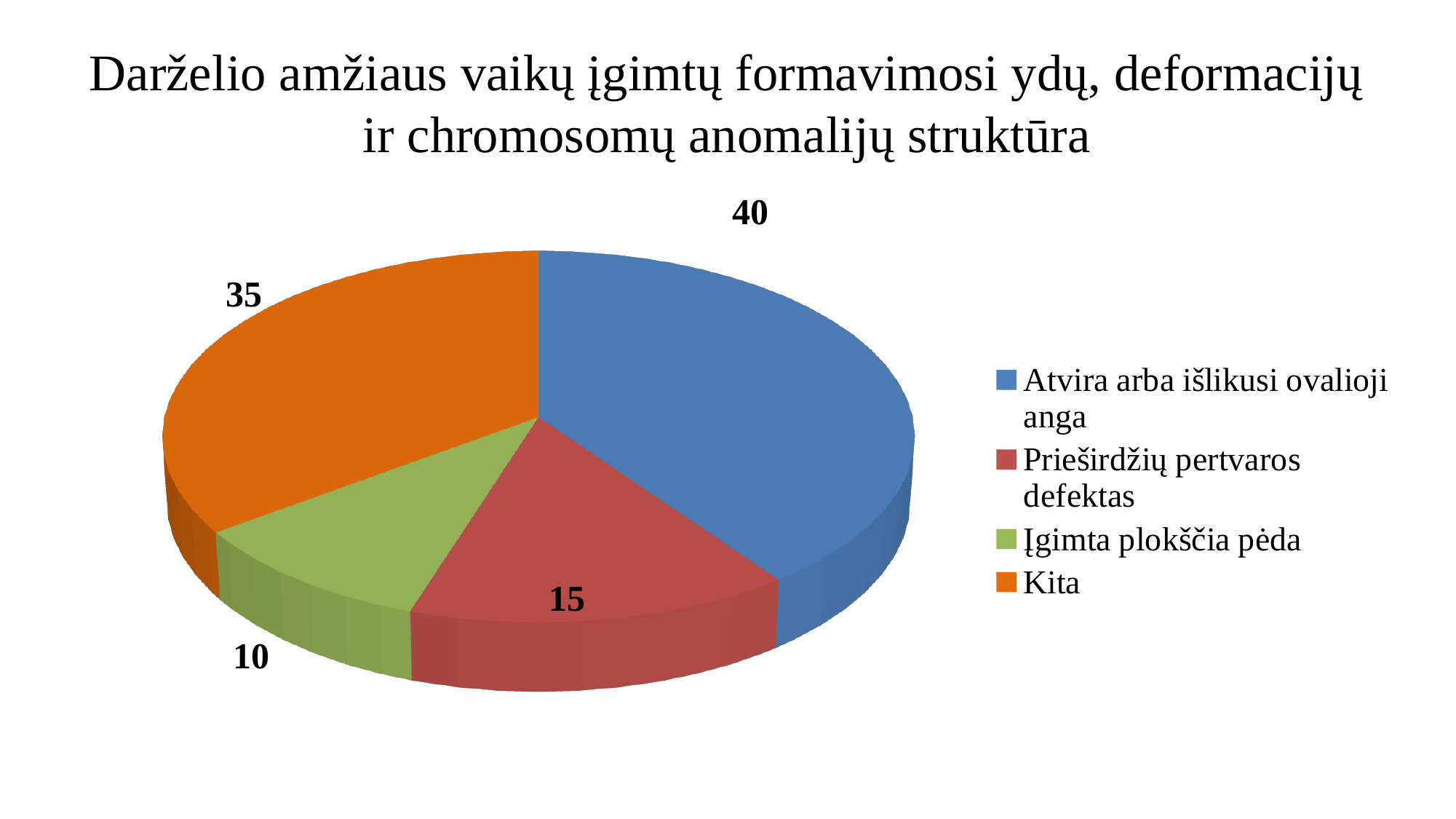
How many categories does the pie chart have? 4 What share of the pie does Kita represent? 35% What kind of chart is shown on the slide? Pie chart Which is larger, the value for Prieširdžių pertvaros defektas or the value for Įgimta plokščia pėda? Prieširdžių pertvaros defektas Which category has the smallest slice of the pie? Įgimta plokščia pėda What is the value for Prieširdžių pertvaros defektas? 15 What is the value for Kita? 35 What is the value for Atvira arba išlikusi ovalioji anga? 40 What is the value for Įgimta plokščia pėda? 10 What is the difference between the values for Atvira arba išlikusi ovalioji anga and Kita? 5 Which category has the largest slice of the pie? Atvira arba išlikusi ovalioji anga What colour is the slice for Kita? Orange